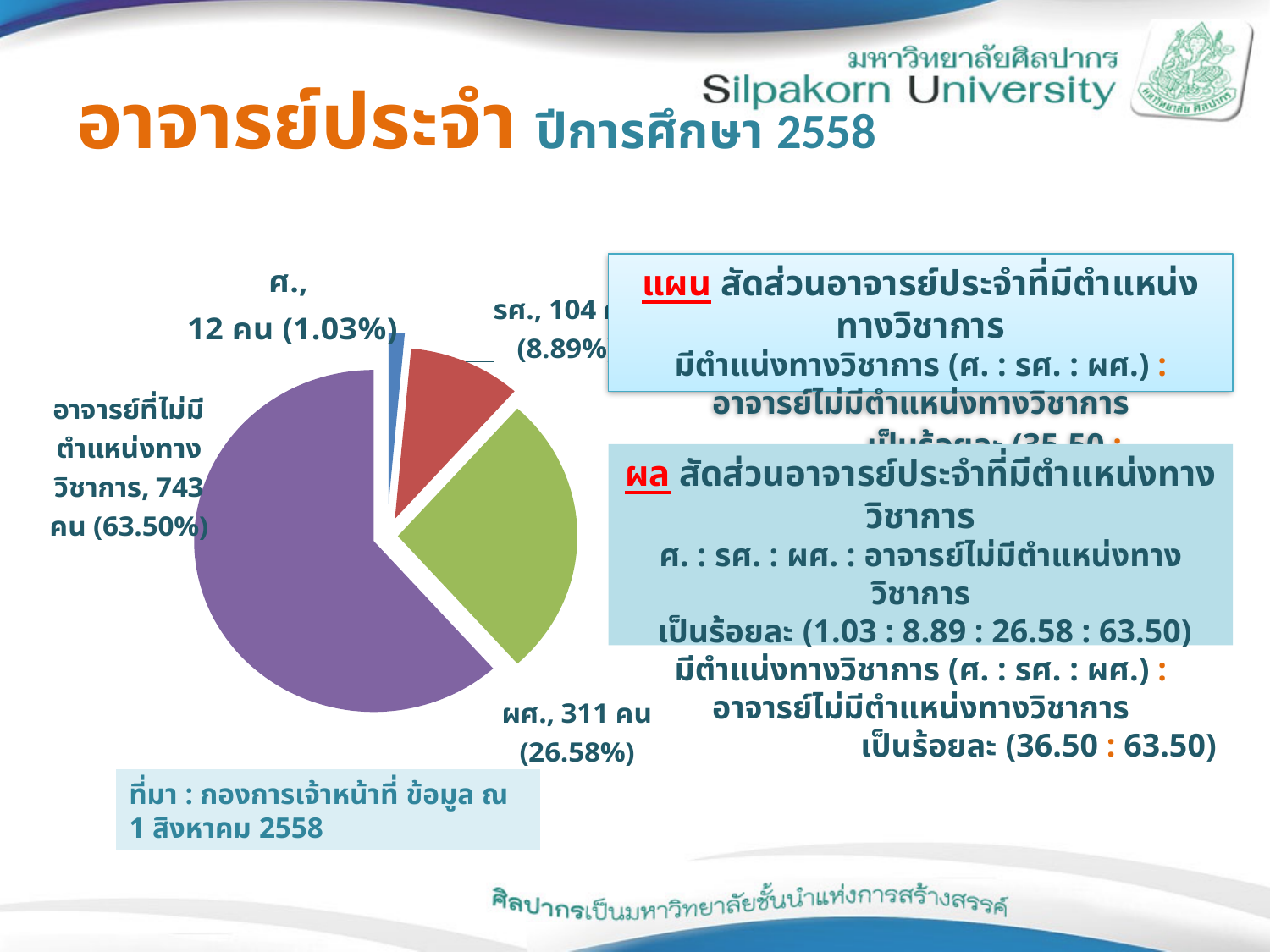
How many people are in the อาจารย์ที่ไม่มีตำแหน่งทางวิชาการ slice? 743 คน What is the difference in number of people between the ผศ. slice and the ศ. slice? 299 คน What percentage of the pie does the ผศ. slice represent? 26.58% What percentage of the pie does the อาจารย์ที่ไม่มีตำแหน่งทางวิชาการ slice represent? 63.50% Which slice is larger, ผศ. or รศ.? ผศ. How many people are in the ศ. slice of the pie chart? 12 คน How many people are in the ผศ. slice of the pie chart? 311 คน What kind of chart is shown on the slide? pie chart What percentage of the pie does the ศ. slice represent? 1.03% How many slices does the pie chart have? 4 Which slice of the pie chart is the largest? อาจารย์ที่ไม่มีตำแหน่งทางวิชาการ Which slice of the pie chart is the smallest? ศ.